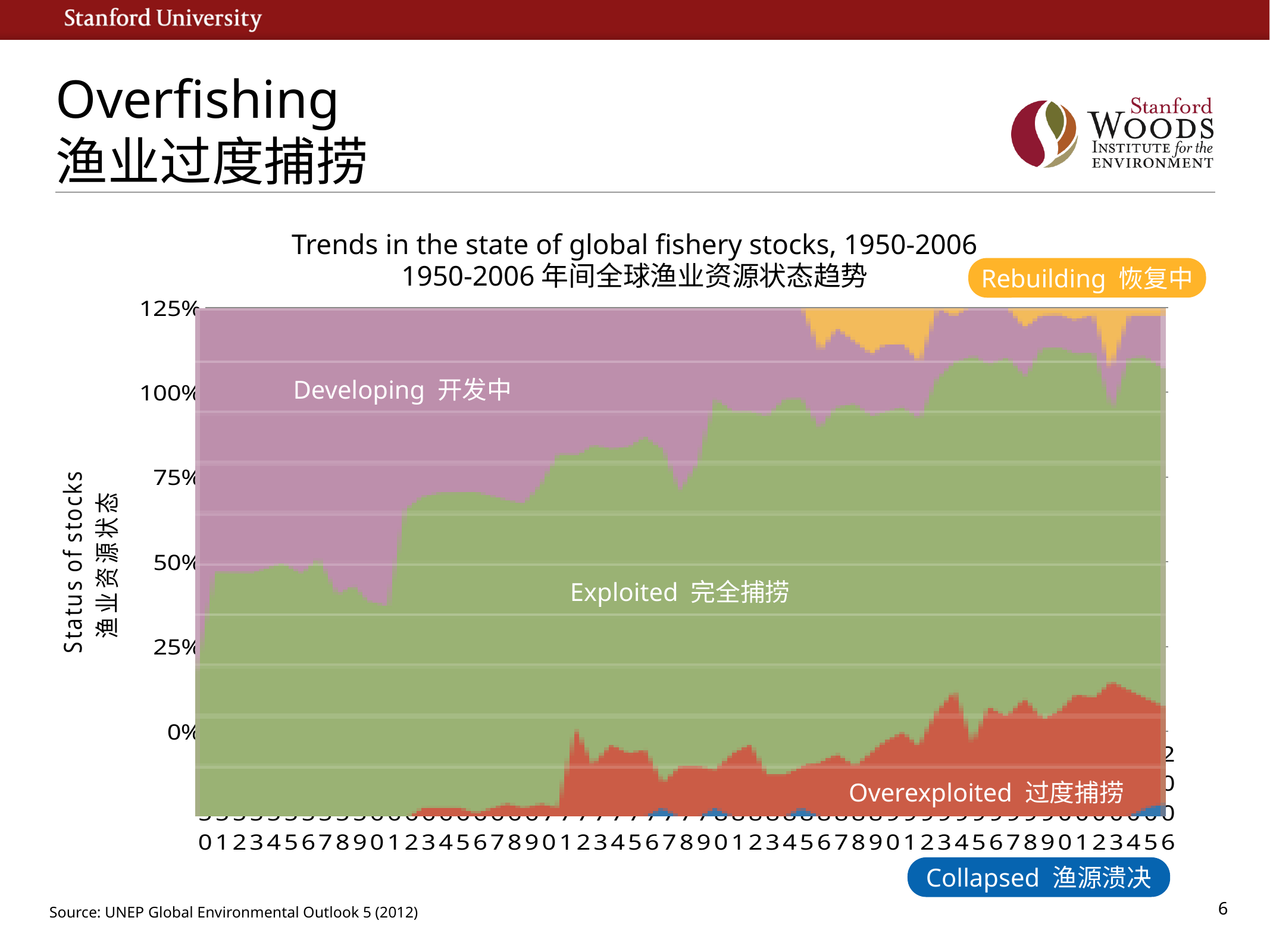
Does the Developing share of stocks rise or fall from 1950 to 2006? fall Which stock status category has the largest share in 1950? Developing How many stock status categories are labelled on the chart? 5 What kind of chart is shown on the slide? area chart Does the Exploited share of stocks rise or fall from 1950 to 2006? rise In 1950, which is larger: the Developing share or the Overexploited share? Developing Which stock status category has the largest share in 2006? Exploited Which stock status category is shown by the green area? Exploited Which stock status category only appears in the later years of the chart? Rebuilding In 2006, which is larger: the Exploited share or the Collapsed share? Exploited What is the title of the chart? Trends in the state of global fishery stocks, 1950-2006